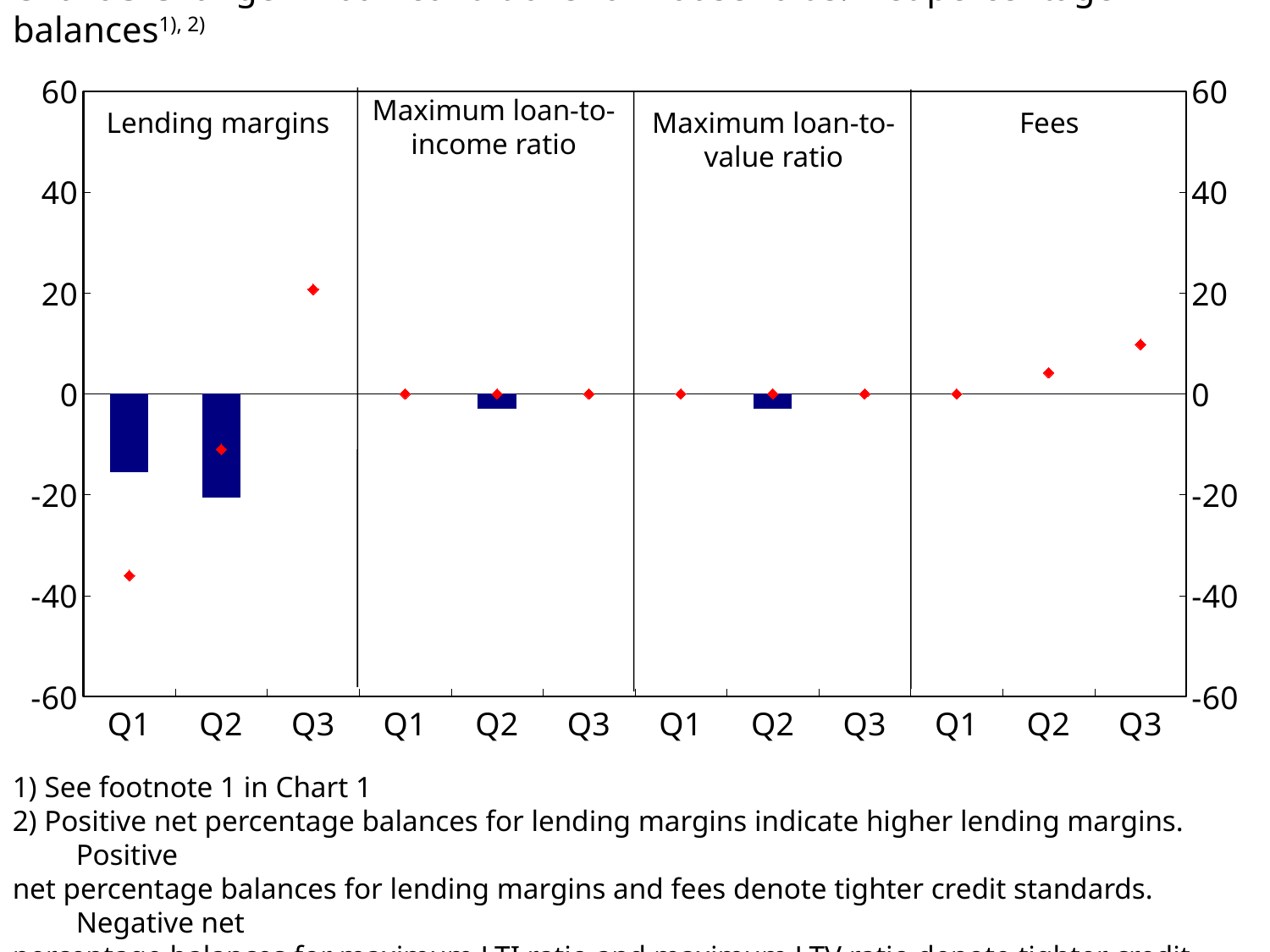
In the Lending margins panel, is the red marker for Q1 greater or less than -20? less What kind of chart is shown on the slide? combination chart with bars and red diamond markers In the Lending margins panel, is the bar for Q1 greater or less than -20? greater What are the names of the four panels in the chart? Lending margins, Maximum loan-to-income ratio, Maximum loan-to-value ratio, Fees In the Fees panel, is the red marker for Q3 greater or less than 20? less In the Lending margins panel, do the red markers rise or fall from Q1 to Q3? rise How many quarters are plotted in each panel of the chart? 3 In the Lending margins panel, which quarter has the lowest bar? Q2 How many panels (categories) does the chart have? 4 In the Fees panel, do the red markers rise or fall from Q1 to Q3? rise In the Fees panel, which quarter has the higher red marker, Q2 or Q3? Q3 What is the range of the vertical axis in the chart? -60 to 60